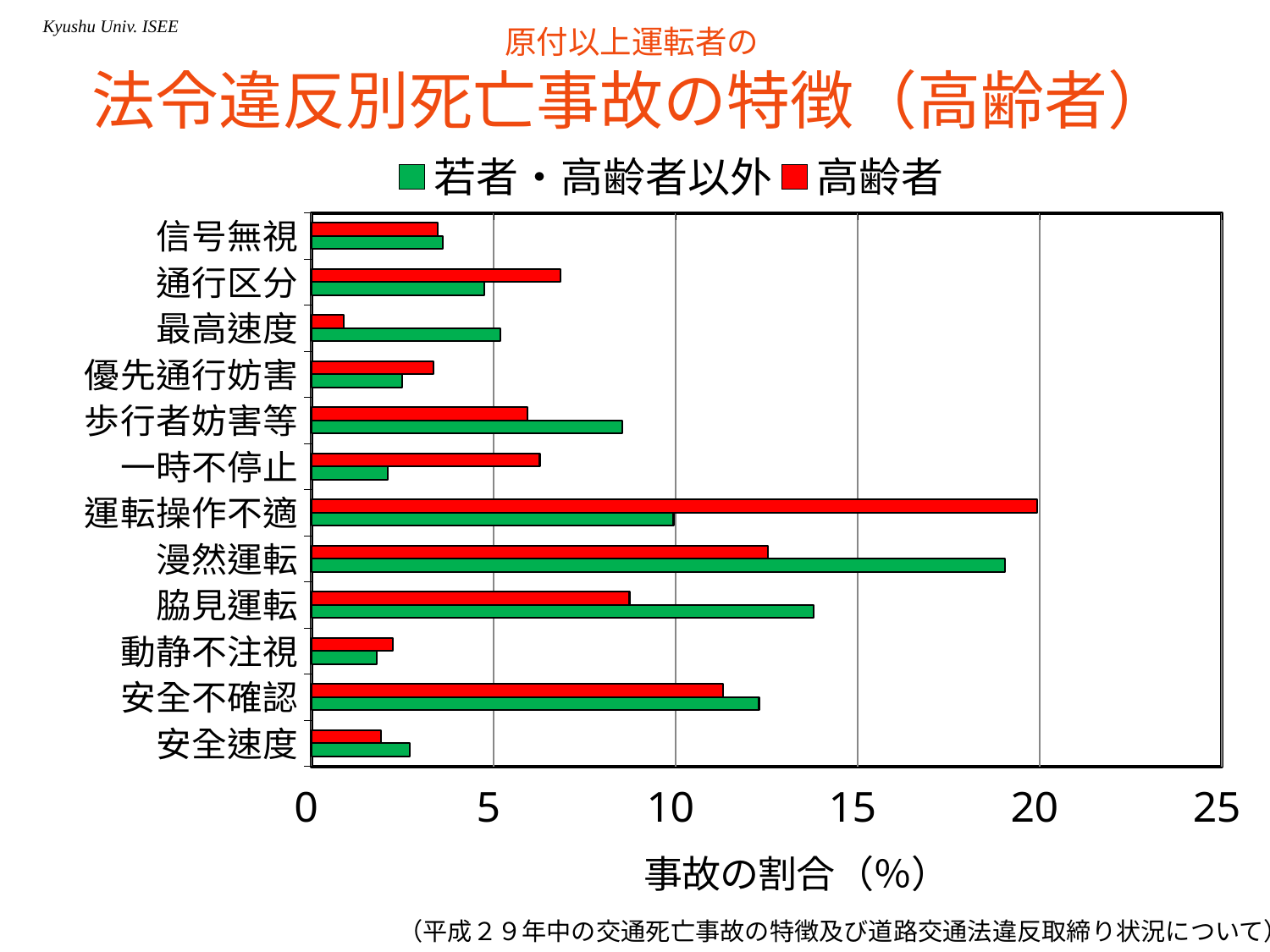
Is the 高齢者 value for 最高速度 greater or less than 5? less What colour represents the 高齢者 series in the legend? red For 運転操作不適, which series has the larger value, 高齢者 or 若者・高齢者以外? 高齢者 How many violation categories are plotted on the y axis? 12 Is the 高齢者 value for 安全不確認 greater or less than 10? greater Which category has the highest value for the 高齢者 series? 運転操作不適 How many series does the legend list? 2 Which category has the lowest value for the 高齢者 series? 最高速度 Is the 若者・高齢者以外 value for 漫然運転 greater or less than 15? greater What kind of chart is shown on the slide? bar chart Which category has the highest value for the 若者・高齢者以外 series? 漫然運転 For 漫然運転, which series has the larger value, 高齢者 or 若者・高齢者以外? 若者・高齢者以外